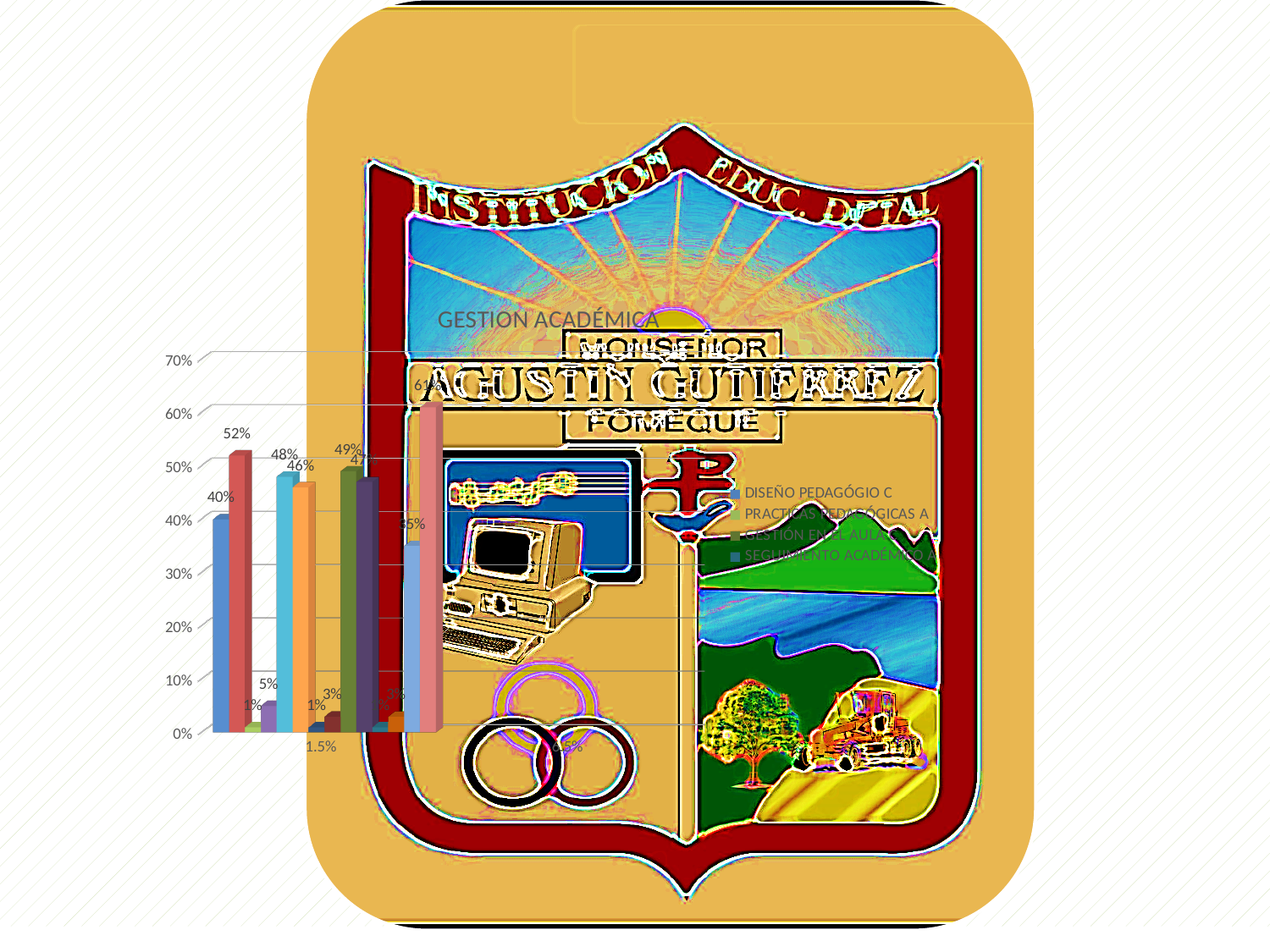
What kind of chart is shown on the slide? bar chart What is the value of the blue bar in the leftmost group of bars? 40% Is the blue bar in the leftmost group greater or less than 30%? greater In the leftmost group of bars, what is the difference between the red bar (52%) and the blue bar (40%)? 12% In the leftmost group of bars, which is larger, the red bar or the blue bar? the red bar What is the title of the chart on the slide? GESTION ACADÉMICA What is the highest data label value shown on the chart? 61% Is the tallest bar on the chart greater or less than 60%? greater What is the first entry listed in the chart's legend? DISEÑO PEDAGÓGIO C How many entries does the chart's legend list? 4